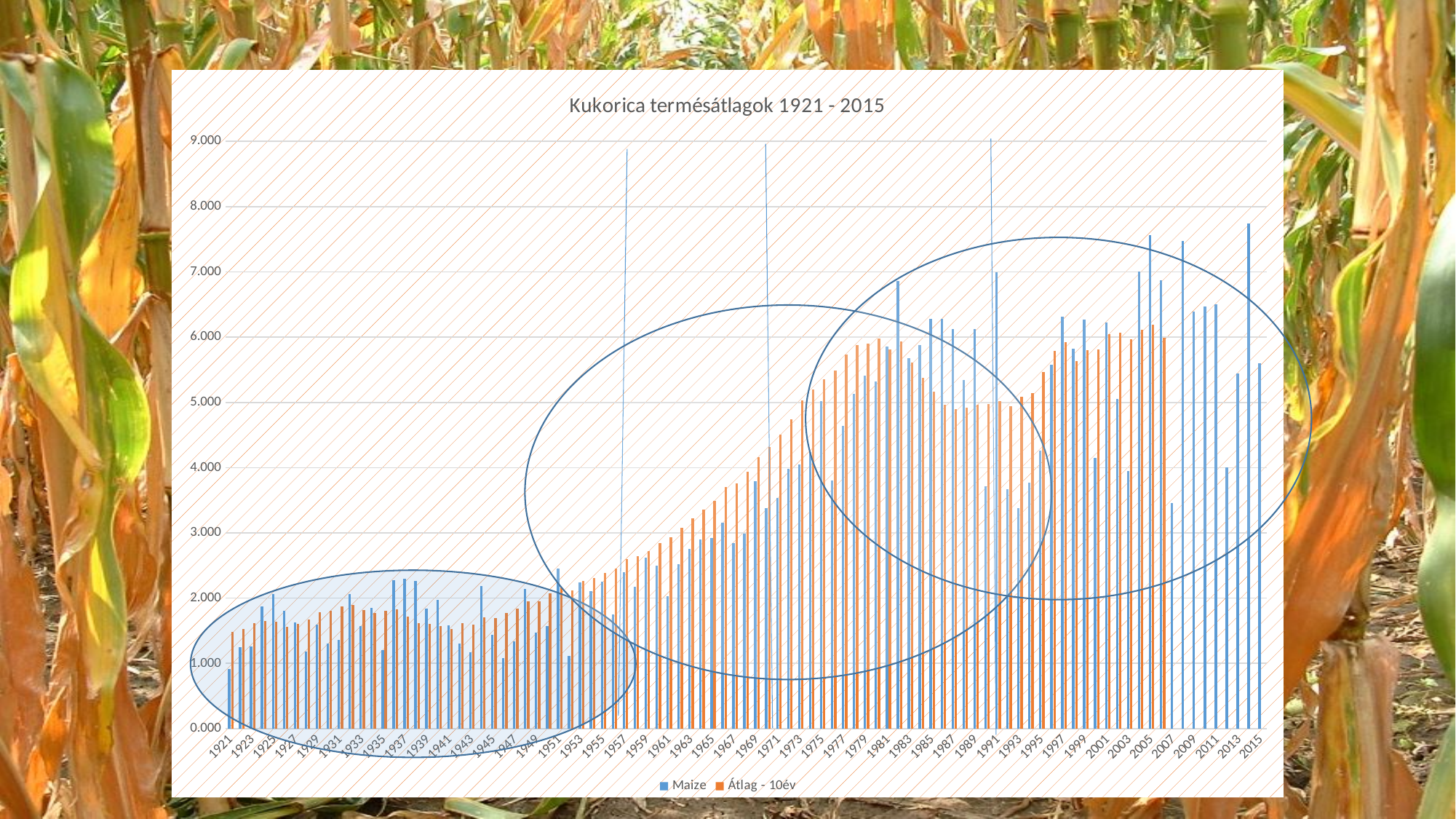
Is the Maize value for 1983 greater or less than 6.000? less Do the Átlag - 10év values rise or fall from 1955 to 1979? rise Is the Maize value for 1921 greater or less than 1.000? less Is the Maize value for 2015 greater or less than 7.000? less Which series is shown in orange in the legend? Átlag - 10év What is the title of the chart? Kukorica termésátlagok 1921 - 2015 How many series does the legend list? 2 What kind of chart is shown on the slide? bar chart